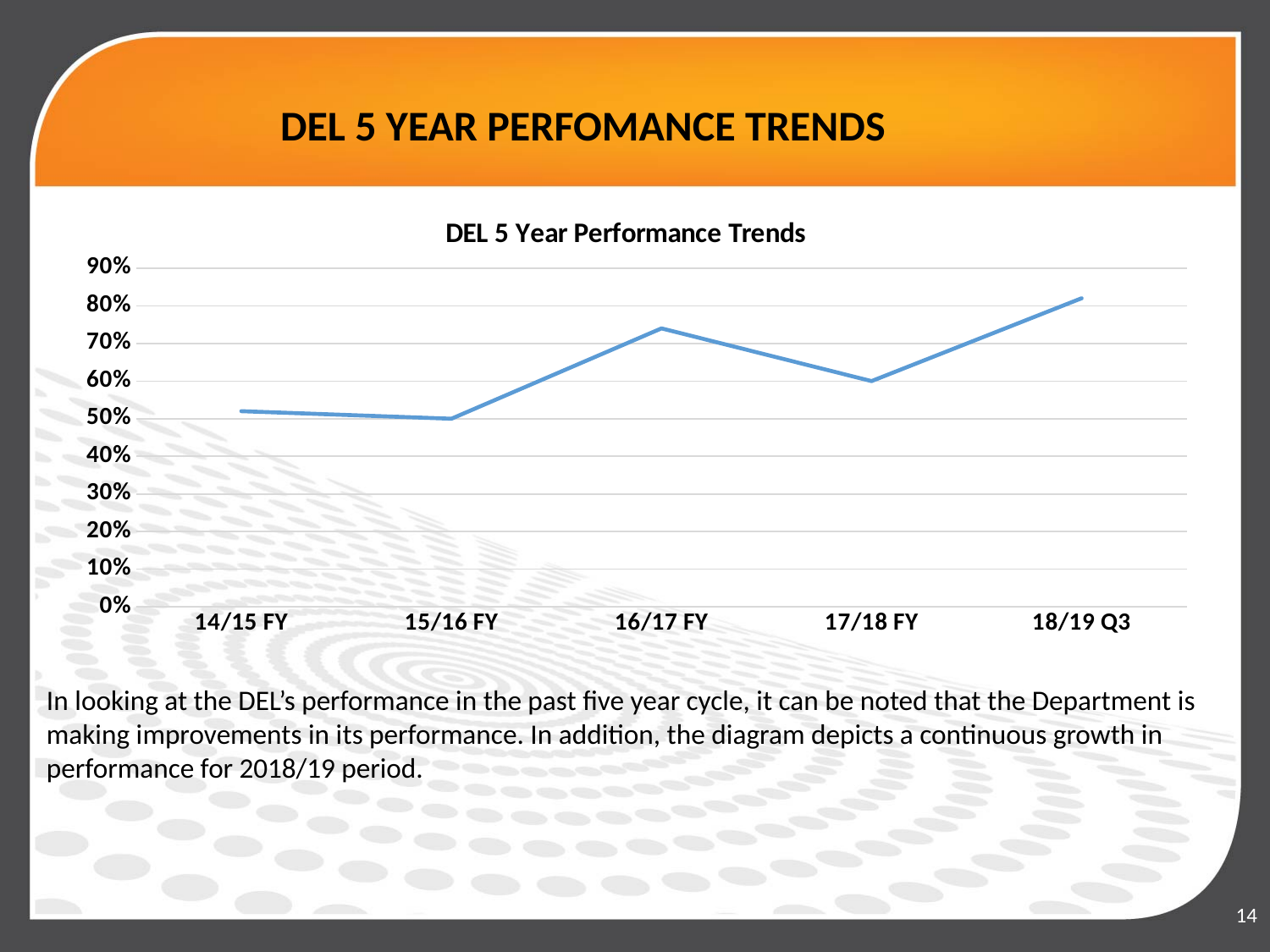
What is the title of the chart? DEL 5 Year Performance Trends Is the value for 14/15 FY greater or less than 60%? less Which is larger, the value for 16/17 FY or the value for 17/18 FY? 16/17 FY Which period has the highest value in the chart? 18/19 Q3 Which period has the lowest value in the chart? 15/16 FY Is the value for 18/19 Q3 greater or less than 70%? greater Does the value rise or fall from 17/18 FY to 18/19 Q3? Rise What kind of chart is shown on the slide? Line chart Does the value rise or fall from 16/17 FY to 17/18 FY? Fall How many periods are plotted along the x axis of the chart? 5 Is the value for 17/18 FY greater or less than 70%? less